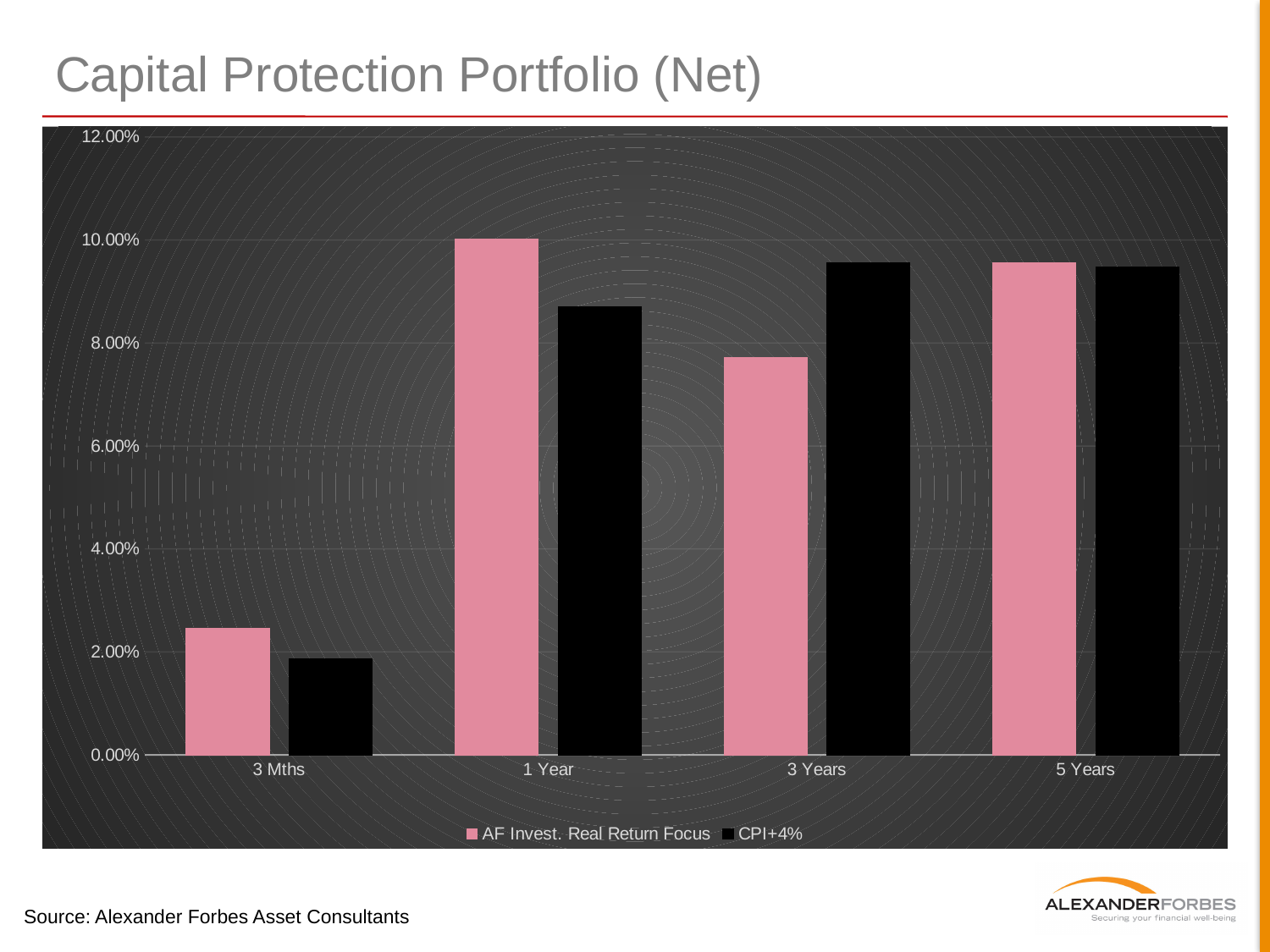
For which period is the AF Invest. Real Return Focus bar the lowest? 3 Mths For which period is the AF Invest. Real Return Focus bar the highest? 1 Year How many time-period categories are shown on the x axis? 4 For which period is the CPI+4% bar the lowest? 3 Mths What kind of chart is shown on the slide? bar chart What is the title of the slide containing the chart? Capital Protection Portfolio (Net) For the 3 Mths period, which is larger: AF Invest. Real Return Focus or CPI+4%? AF Invest. Real Return Focus Is the CPI+4% value for 3 Mths greater or less than 2.00%? less Is the AF Invest. Real Return Focus value for 3 Years greater or less than 8.00%? less For the 3 Years period, which is larger: AF Invest. Real Return Focus or CPI+4%? CPI+4% How many series does the legend list? 2 For the 1 Year period, which is larger: AF Invest. Real Return Focus or CPI+4%? AF Invest. Real Return Focus